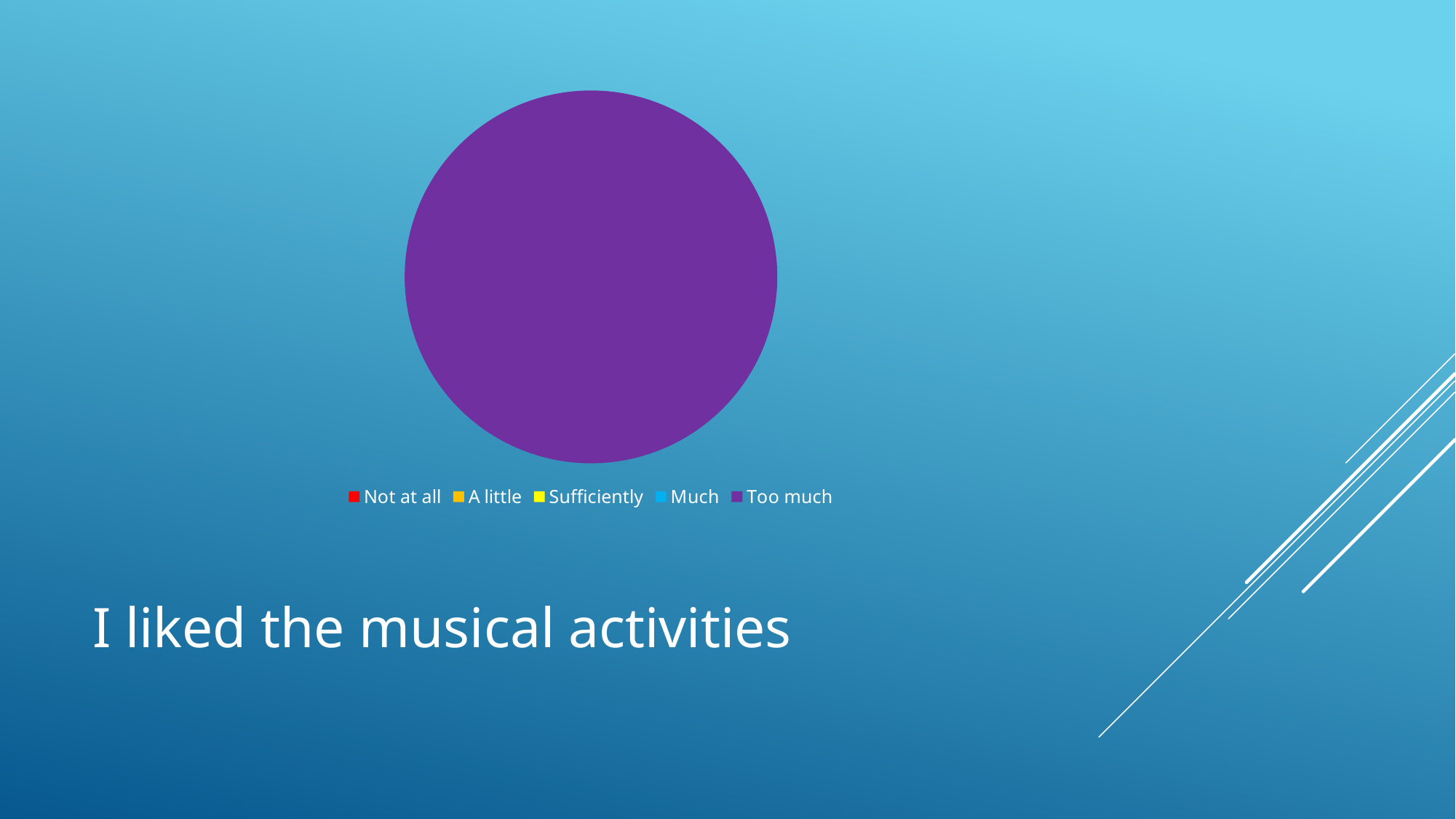
What kind of chart is shown on the slide? pie chart What colour does the legend use for Not at all? red Which category has the largest slice in the pie chart? Too much What colour is the slice for Too much in the pie chart? purple What is the text shown below the pie chart on the slide? I liked the musical activities Which is larger in the pie chart, the slice for Much or the slice for Too much? Too much How many entries does the legend of the pie chart list? 5 Which category fills the entire pie chart? Too much Which is larger in the pie chart, the slice for Too much or the slice for Not at all? Too much